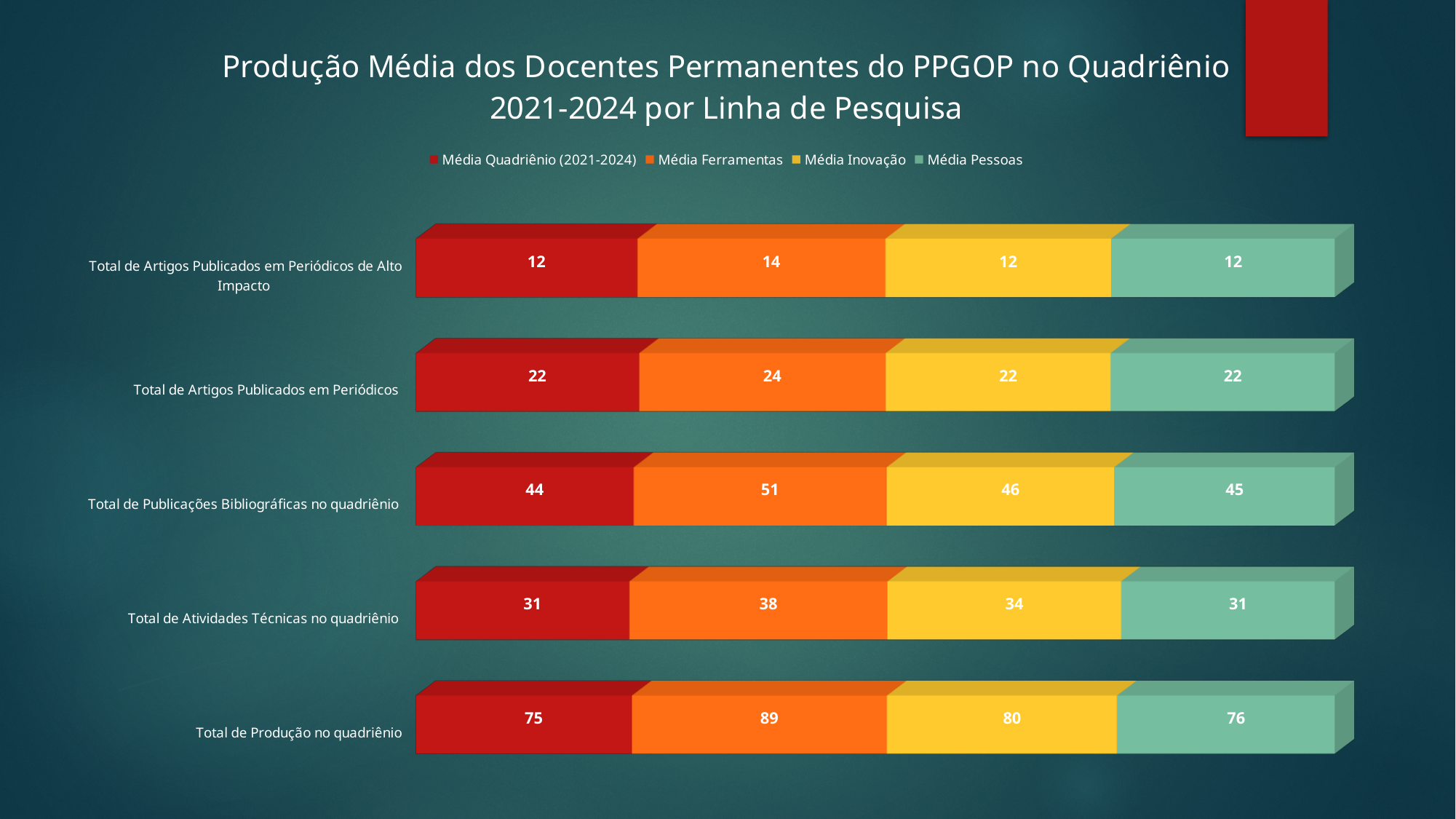
What is the Média Pessoas value for Total de Artigos Publicados em Periódicos? 22 Which series has the highest value for Total de Produção no quadriênio? Média Ferramentas How many series does the legend list? 4 What is the Média Ferramentas value for Total de Produção no quadriênio? 89 What is the difference between the Média Ferramentas and Média Quadriênio (2021-2024) values for Total de Produção no quadriênio? 14 What kind of chart is shown on the slide? Stacked bar chart What is the Média Inovação value for Total de Atividades Técnicas no quadriênio? 34 What is the Média Quadriênio (2021-2024) value for Total de Publicações Bibliográficas no quadriênio? 44 What is the sum of the four values shown for Total de Artigos Publicados em Periódicos de Alto Impacto? 50 For Total de Atividades Técnicas no quadriênio, which is larger: Média Ferramentas or Média Pessoas? Média Ferramentas Which category has the lowest Média Ferramentas value? Total de Artigos Publicados em Periódicos de Alto Impacto How many categories are shown on the chart? 5